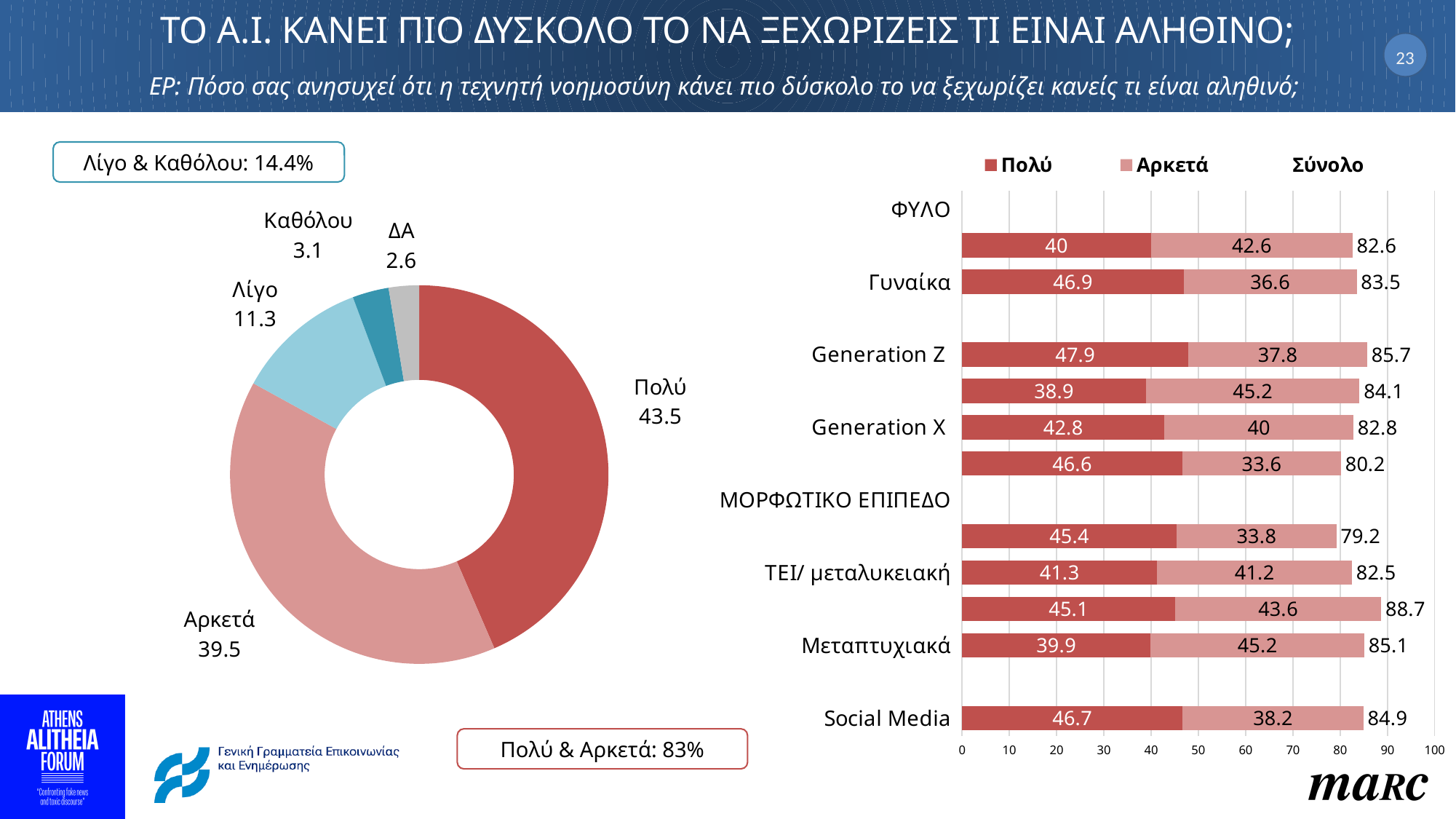
In the bar chart on the right, how many entries does the legend list? 3 In the donut chart on the left, how many slices are there? 5 What kind of chart is shown on the right side of the slide? Stacked bar chart In the donut chart on the left, what is the difference between Πολύ and Αρκετά? 4 In the donut chart on the left, which category has the largest value? Πολύ In the donut chart on the left, what is the value for Πολύ? 43.5 In the donut chart on the left, which category has the smallest value? ΔΑ In the bar chart on the right, which is larger: the Πολύ value for Γυναίκα or the Πολύ value for Generation X? Γυναίκα In the bar chart on the right, what is the Πολύ value for Generation Z? 47.9 In the donut chart on the left, what is the value for Λίγο? 11.3 In the bar chart on the right, what is the Σύνολο value for Μεταπτυχιακά? 85.1 In the bar chart on the right, what is the Αρκετά value for Social Media? 38.2